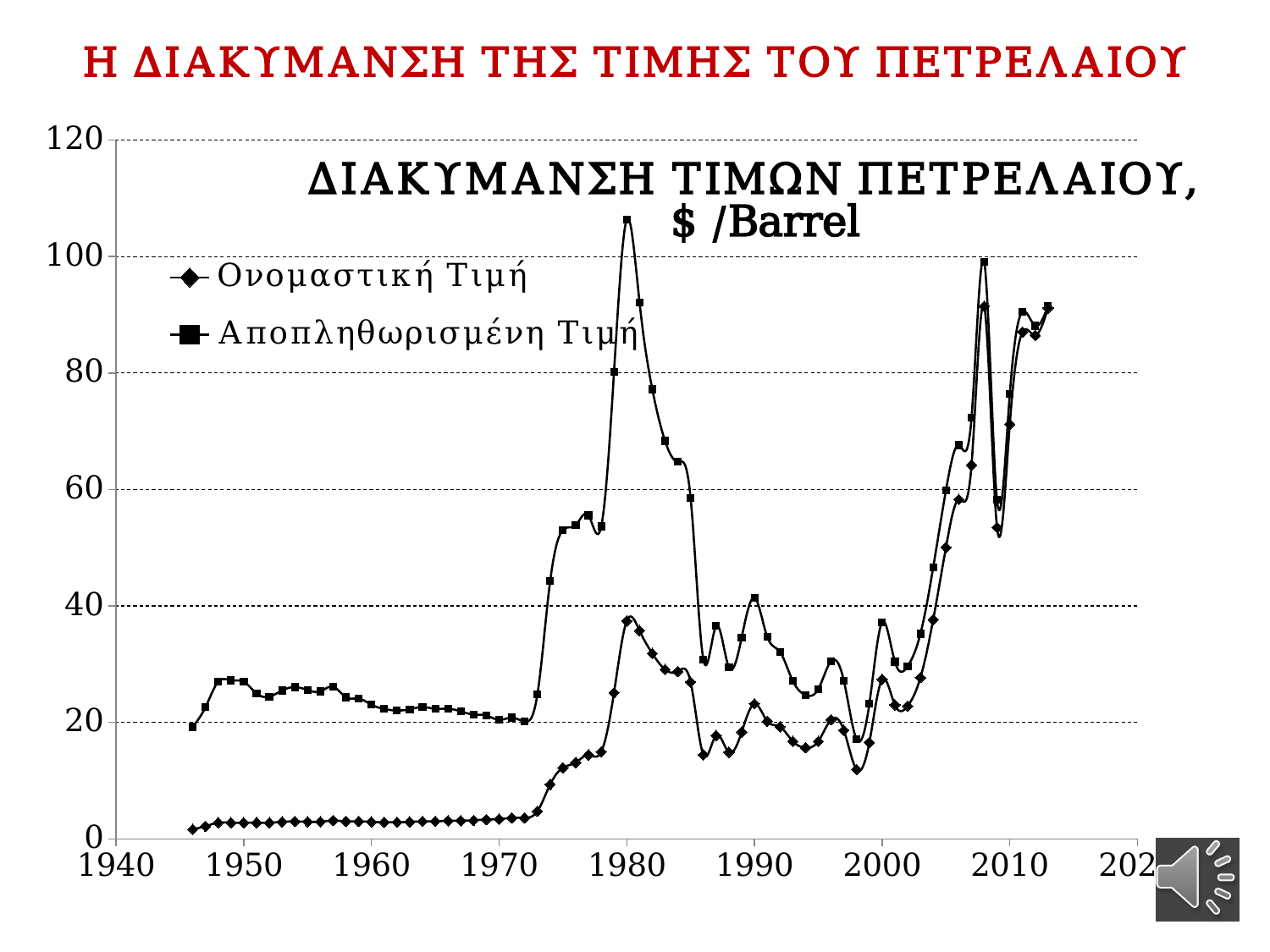
How many series does the legend list? 2 Is the value of Αποπληθωρισμένη Τιμή in 1980 greater or less than 100? greater Does the Αποπληθωρισμένη Τιμή series rise or fall between 1980 and 1986? Fall Is the value of Αποπληθωρισμένη Τιμή in 1950 greater or less than 20? greater Is the value of Ονομαστική Τιμή in 2008 greater or less than 80? greater In which year does the Αποπληθωρισμένη Τιμή series reach its highest value? 1980 What are the two series named in the legend? Ονομαστική Τιμή and Αποπληθωρισμένη Τιμή Does the Ονομαστική Τιμή series rise or fall between 1998 and 2008? Rise What unit is given in the chart title? $ /Barrel What kind of chart is shown on the slide? Line chart In 1980, which series has the higher value, Ονομαστική Τιμή or Αποπληθωρισμένη Τιμή? Αποπληθωρισμένη Τιμή